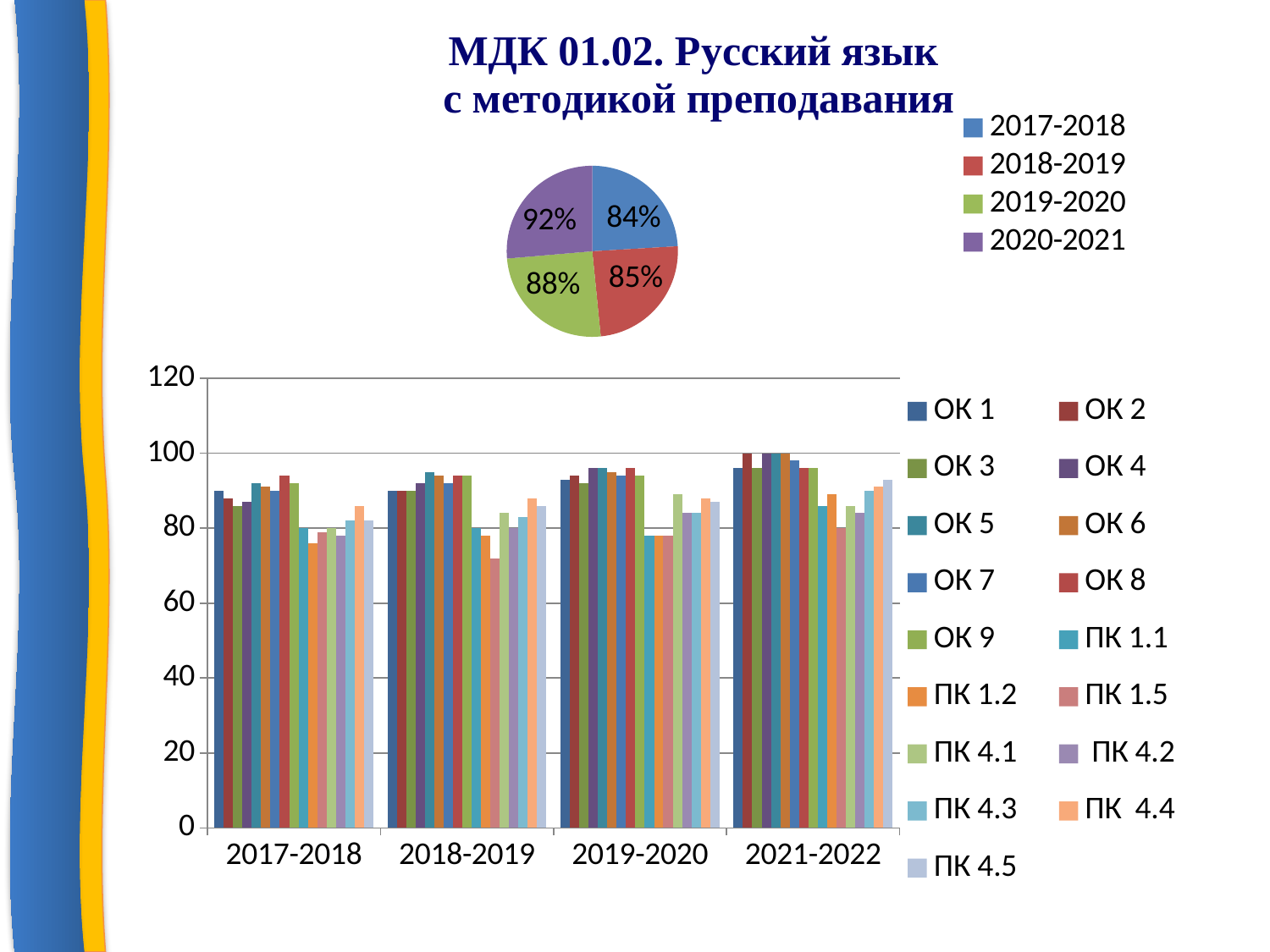
How many series does the legend of the bar chart list? 17 On the pie chart, which year has the lowest value? 2017-2018 On the pie chart, which year has the highest value? 2020-2021 How many categories are shown on the x axis of the bar chart? 4 What kind of chart is the lower chart on the slide? bar chart On the pie chart, what is the value for 2020-2021? 92% On the pie chart, what is the difference between the values for 2020-2021 and 2017-2018? 8% On the pie chart, which is larger: the value for 2018-2019 or the value for 2019-2020? 2019-2020 On the pie chart, what is the value for 2019-2020? 88% On the pie chart, what is the value for 2017-2018? 84% How many entries does the legend of the pie chart list? 4